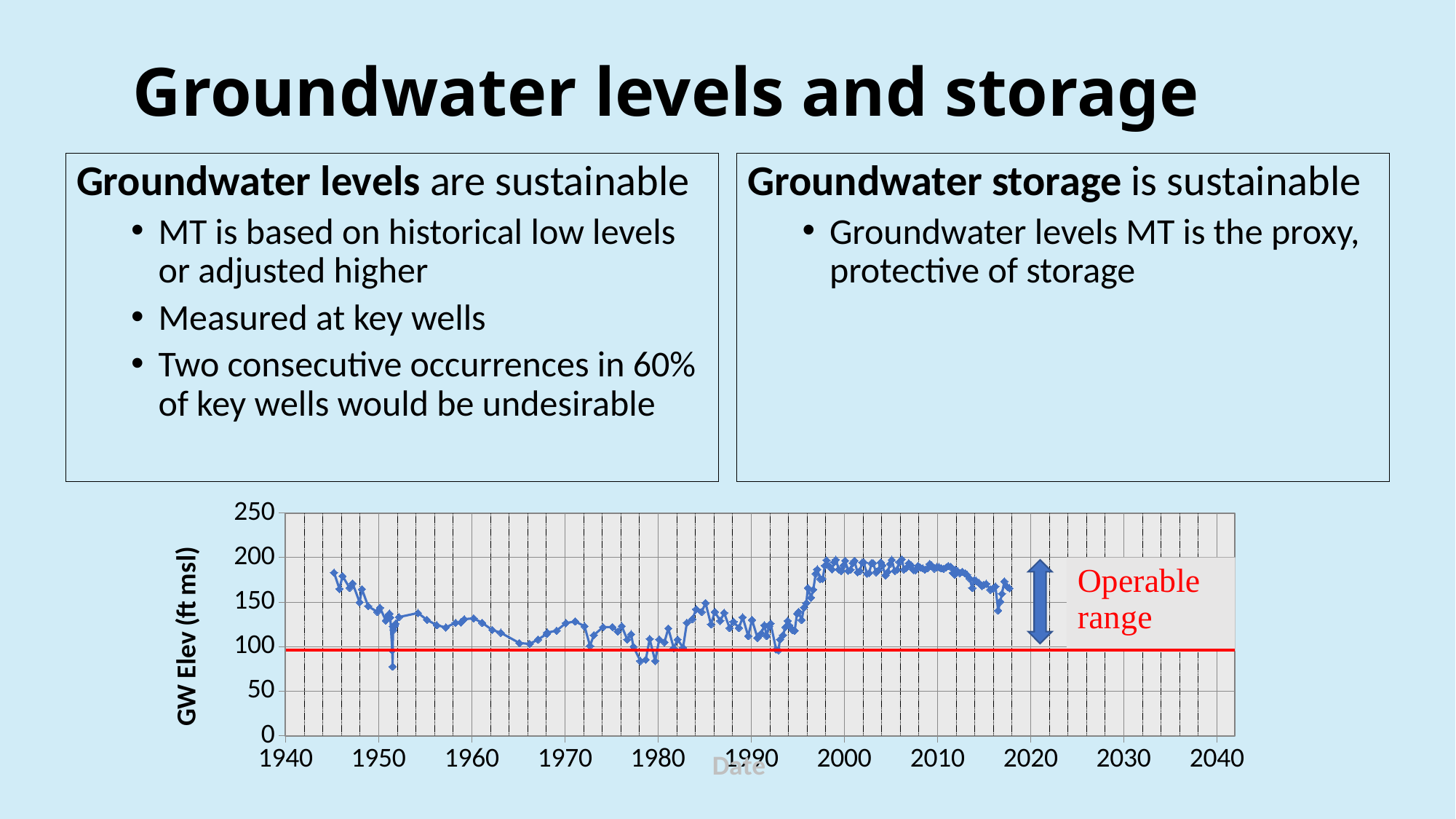
What is the label of the vertical axis of the chart? GW Elev (ft msl) What kind of chart is shown on the slide? line chart Is the groundwater elevation around the year 1980 greater or less than 150? less Between about 2010 and 2018, do the groundwater elevation values rise or fall? fall What text is written in red next to the blue double-headed arrow on the chart? Operable range Is the groundwater elevation around 2005 higher or lower than around 1980? higher Is the groundwater elevation at the start of the record, around 1946, greater or less than 150? greater Is the lowest plotted groundwater elevation, the dip around 1951, greater or less than 100? less Between about 1990 and 2000, do the groundwater elevation values rise or fall? rise Between about 1945 and 1965, do the groundwater elevation values generally rise or fall? fall